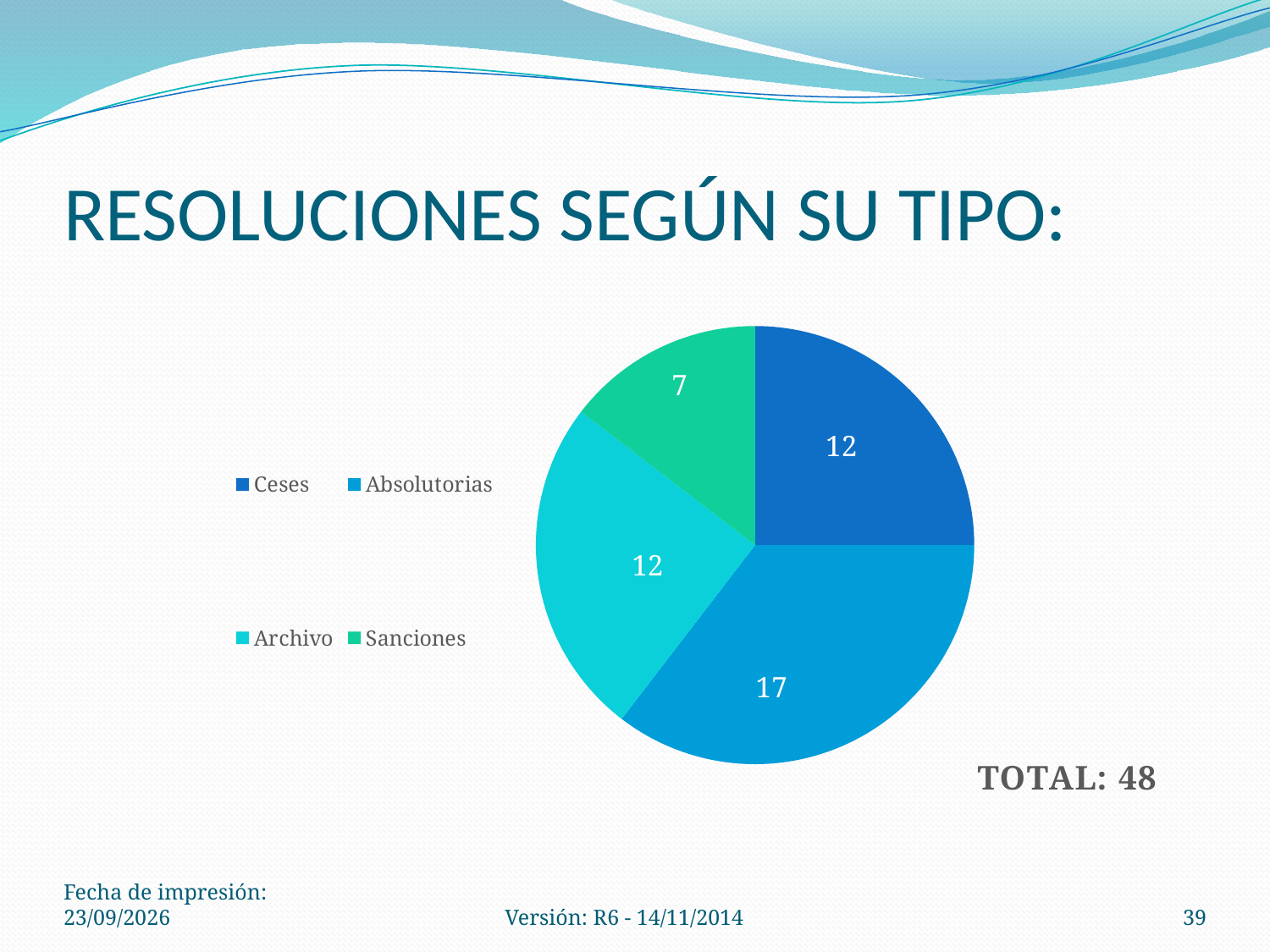
Which category has the largest slice of the pie? Absolutorias Which category has the smallest slice of the pie? Sanciones What is the value for Archivo? 12 What is the difference between the values for Absolutorias and Sanciones? 10 What is the value for Sanciones? 7 What is the value for Absolutorias? 17 What kind of chart is shown on the slide? pie chart What is the value for Ceses? 12 What is the total shown on the slide for all resolutions? 48 Which is larger, the value for Absolutorias or the value for Ceses? Absolutorias How many categories does the pie chart show? 4 What share of the pie does Ceses represent? 25%